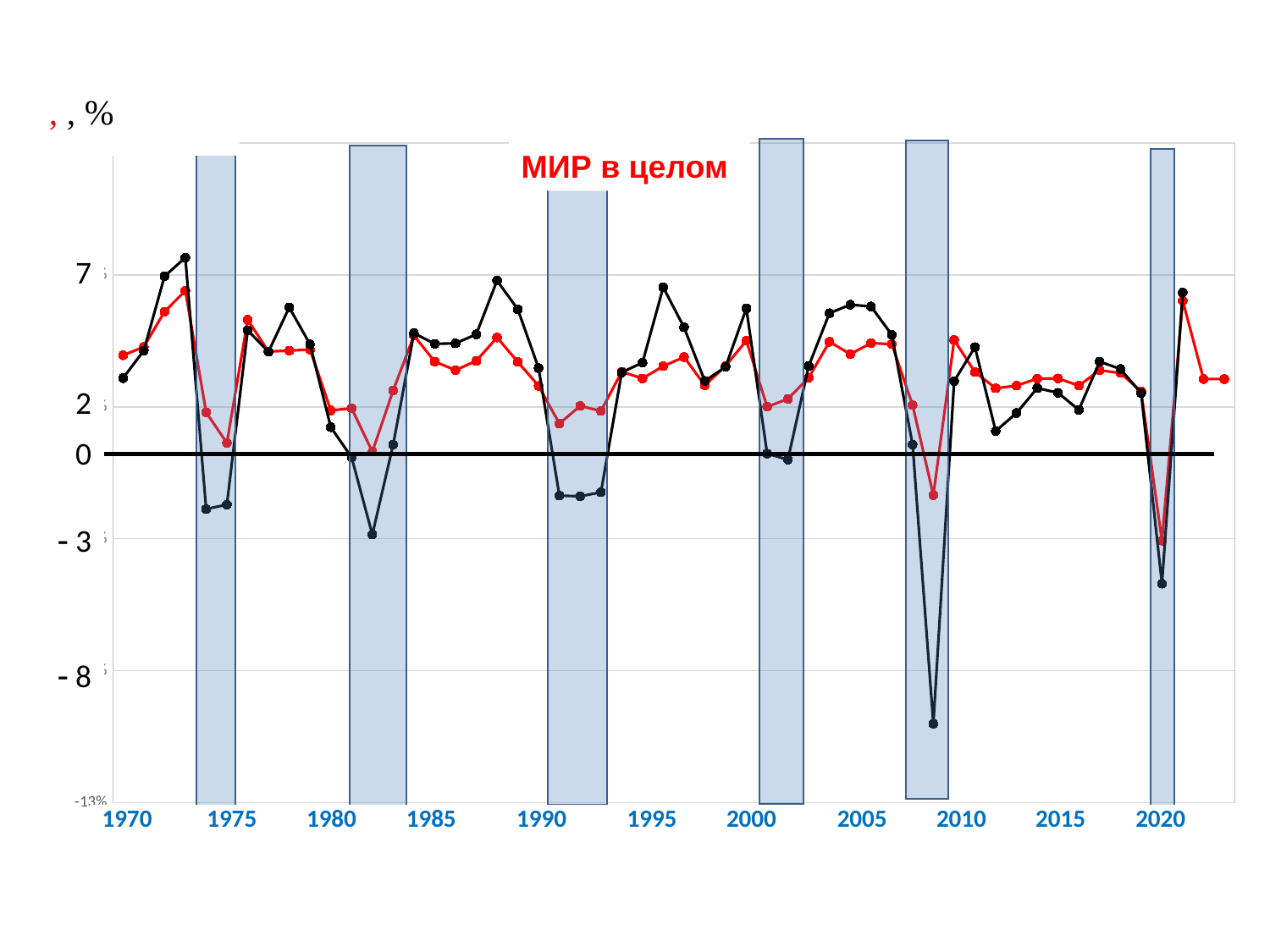
What kind of chart is shown on the slide? line chart Is the value of the black series in 2009 greater or less than -8? less Which series label is printed in red on the chart? МИР в целом How many shaded vertical bands are drawn on the chart? 6 In which year does the black series reach its lowest value? 2009 Is the value of the red series (МИР в целом) in 2020 greater or less than 0? less In 1988, which series has the higher value, the black series or the red series (МИР в целом)? black series In which year does the red series (МИР в целом) reach its lowest value? 2020 Does the black series rise or fall from 1970 to 1973? rise Is the value of the black series in 2020 greater or less than -3? less In 2009, which series has the lower value, the black series or the red series (МИР в целом)? black series